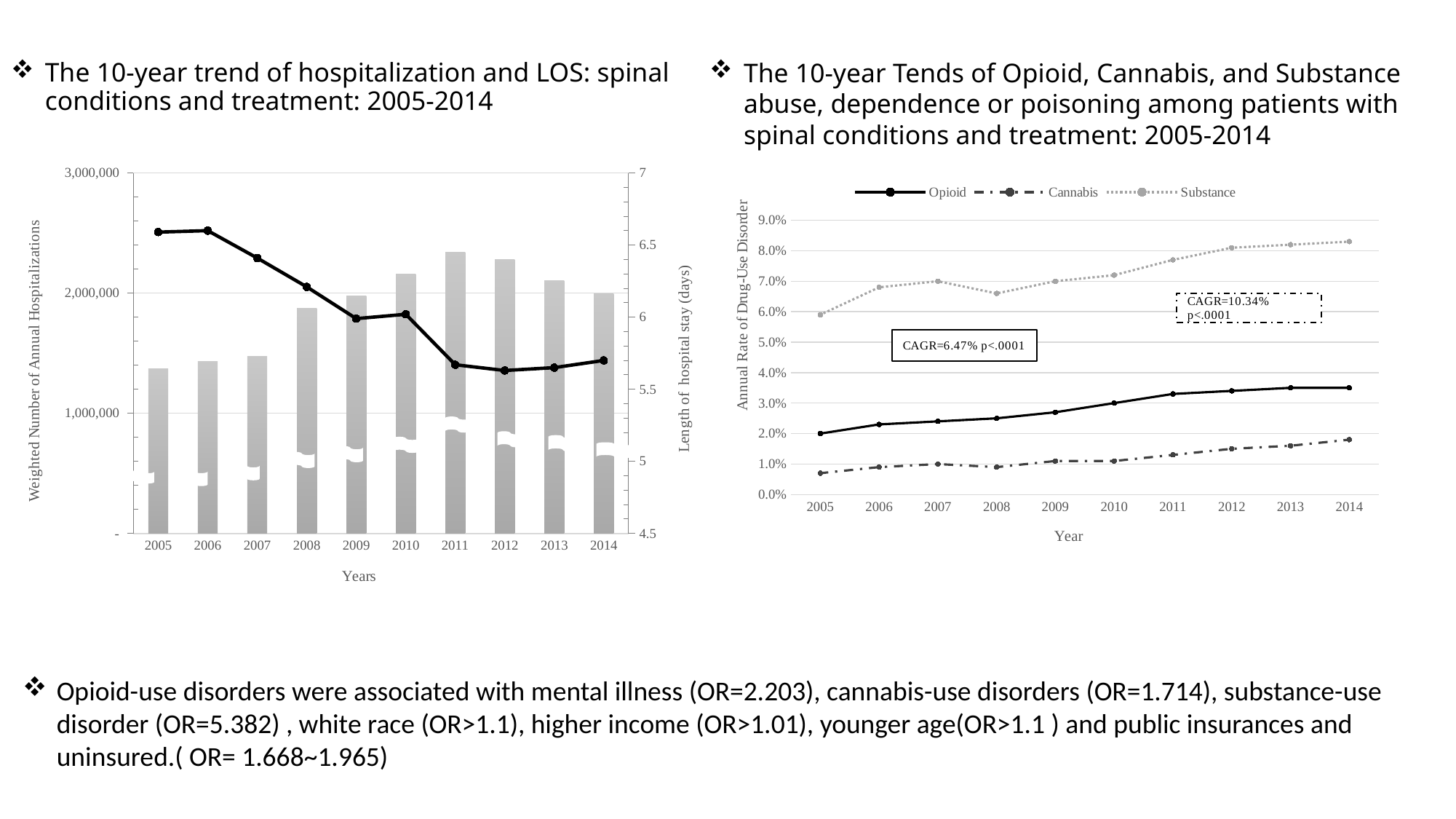
In the left chart (hospitalization and LOS), which year has the larger bar for hospitalizations, 2007 or 2010? 2010 In the left chart (hospitalization and LOS), which year has the shortest bar for weighted number of annual hospitalizations? 2005 In the left chart (hospitalization and LOS), is the length of hospital stay in 2005 greater or less than 6.5 days? greater In the right chart (drug-use disorder trends), what CAGR is printed in the dashed annotation box near the Substance line? CAGR=10.34% p<.0001 In the left chart (hospitalization and LOS), does the length of hospital stay line rise or fall from 2005 to 2014? fall In the right chart (drug-use disorder trends), is the Substance rate in 2014 greater or less than 8.0%? greater In the right chart (drug-use disorder trends), which series has the highest annual rate in 2014? Substance In the left chart (hospitalization and LOS), how many years are shown on the x axis? 10 In the left chart (hospitalization and LOS), which year has the tallest bar for weighted number of annual hospitalizations? 2011 In the right chart (drug-use disorder trends), does the Opioid line rise or fall from 2005 to 2014? rise In the right chart (drug-use disorder trends), how many series does the legend list? 3 In the left chart (hospitalization and LOS), is the weighted number of annual hospitalizations in 2005 greater or less than 2,000,000? less